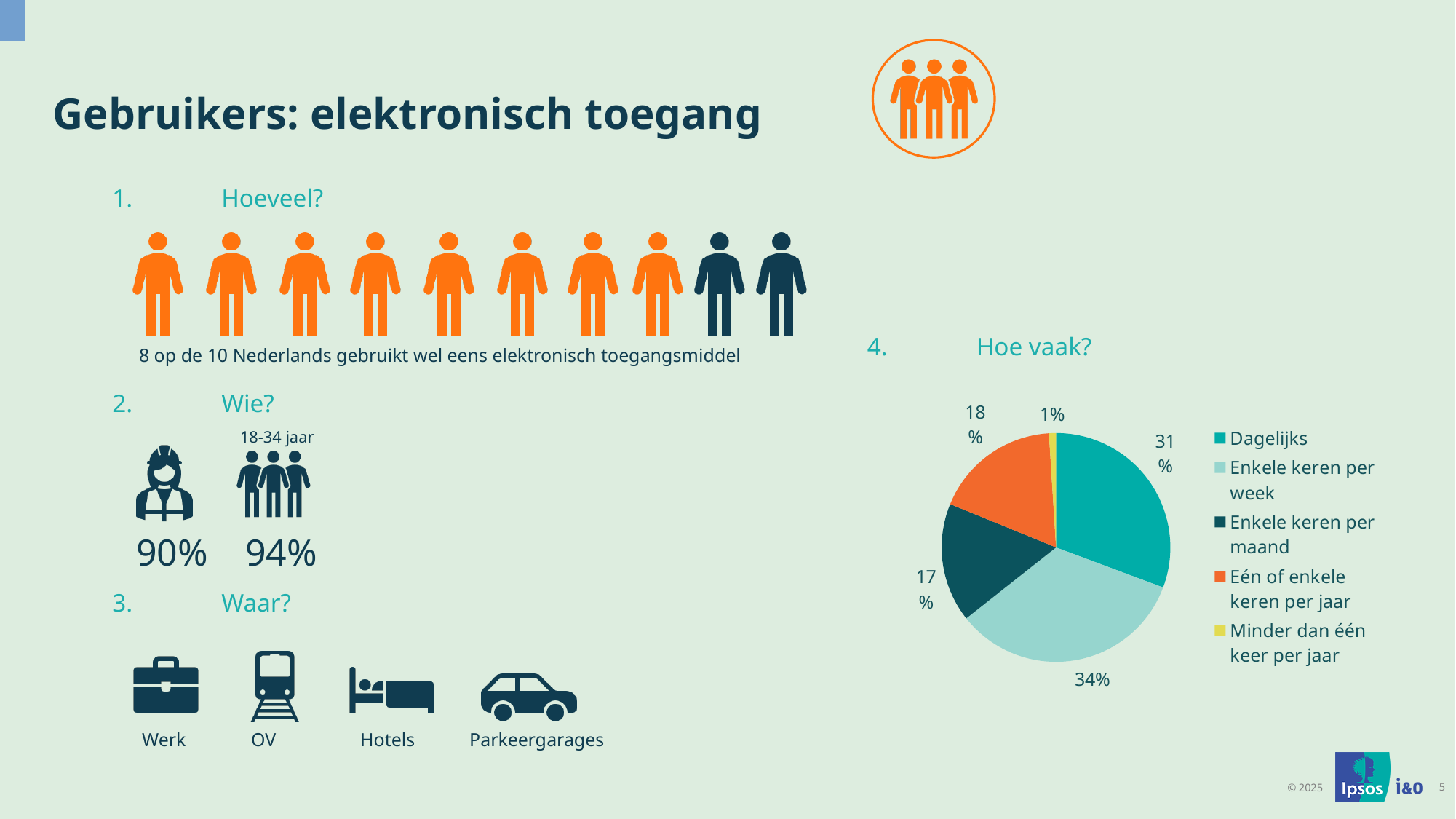
In the 'Hoe vaak?' pie chart, what is the difference between 'Enkele keren per week' and 'Dagelijks'? 3% In the 'Hoe vaak?' pie chart, what share is 'Eén of enkele keren per jaar'? 18% In the 'Hoe vaak?' pie chart, which is larger: 'Dagelijks' or 'Enkele keren per maand'? Dagelijks In the 'Hoe vaak?' pie chart, what colour is the 'Eén of enkele keren per jaar' slice? orange In the 'Hoe vaak?' pie chart, what share is 'Enkele keren per week'? 34% In the 'Hoe vaak?' pie chart, what share is 'Dagelijks'? 31% What kind of chart is shown under 'Hoe vaak?'? pie chart In the 'Hoe vaak?' pie chart, what share is 'Enkele keren per maand'? 17% In the 'Hoe vaak?' pie chart, what share is 'Minder dan één keer per jaar'? 1% How many categories does the legend of the 'Hoe vaak?' pie chart list? 5 In the 'Hoe vaak?' pie chart, which category has the largest share? Enkele keren per week In the 'Hoe vaak?' pie chart, which category has the smallest share? Minder dan één keer per jaar